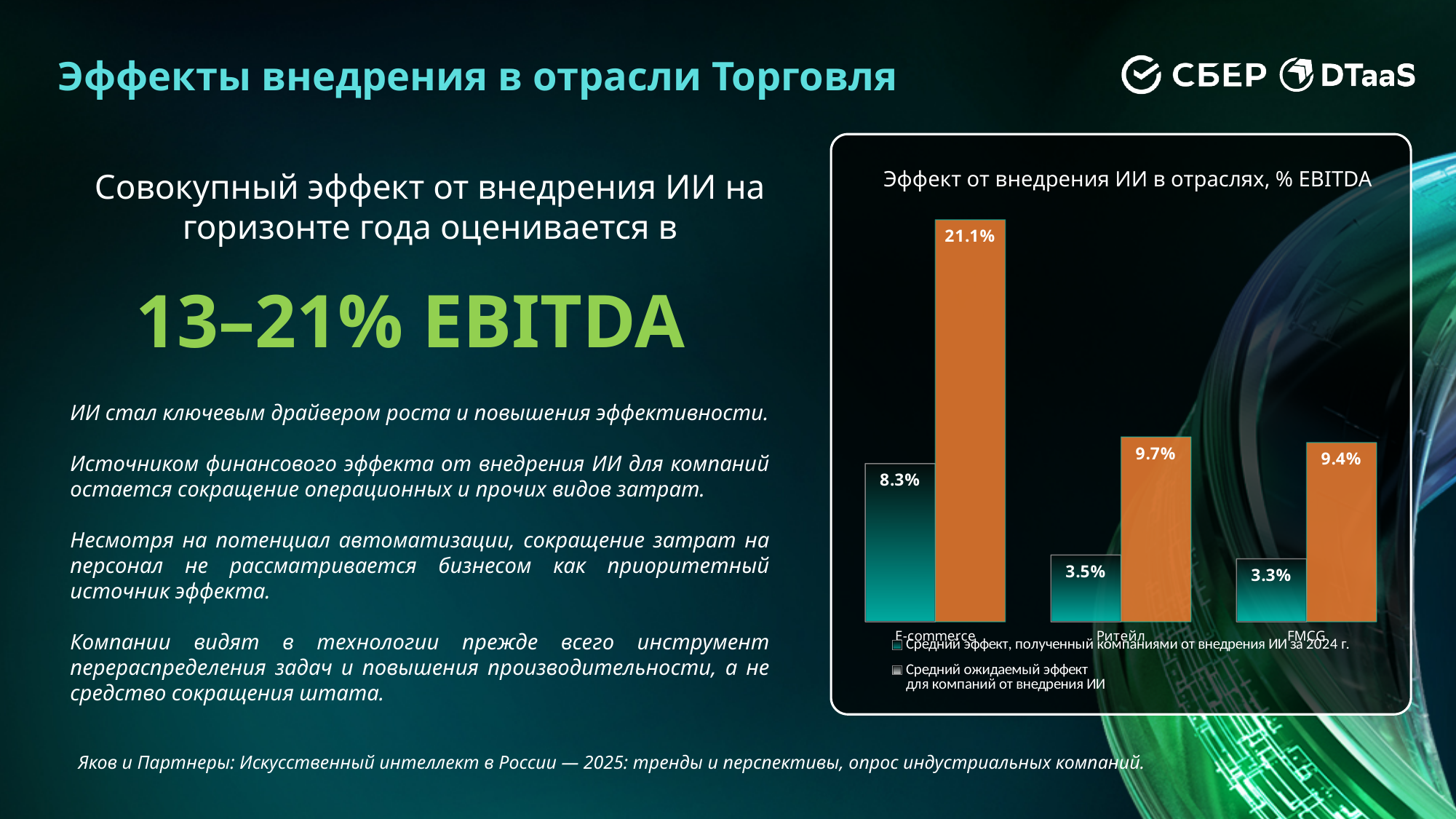
What is the difference between the expected effect and the effect obtained in 2024 for E-commerce? 12.8% What is the average effect obtained by companies from AI implementation in 2024 for E-commerce? 8.3% What type of chart is shown on the slide? Bar chart What is the average expected effect from AI implementation for Ритейл? 9.7% Which industry has the lowest average effect obtained from AI implementation in 2024? FMCG Which is larger: the effect obtained in 2024 for E-commerce or the expected effect for FMCG? Expected effect for FMCG (9.4%) What is the title of the chart? Эффект от внедрения ИИ в отраслях, % EBITDA What is the difference between the expected effect for E-commerce and the expected effect for Ритейл? 11.4% Which industry has the highest average expected effect from AI implementation? E-commerce How many industries are shown on the chart? 3 How many series does the chart legend list? 2 What is the average effect obtained in 2024 for FMCG? 3.3%